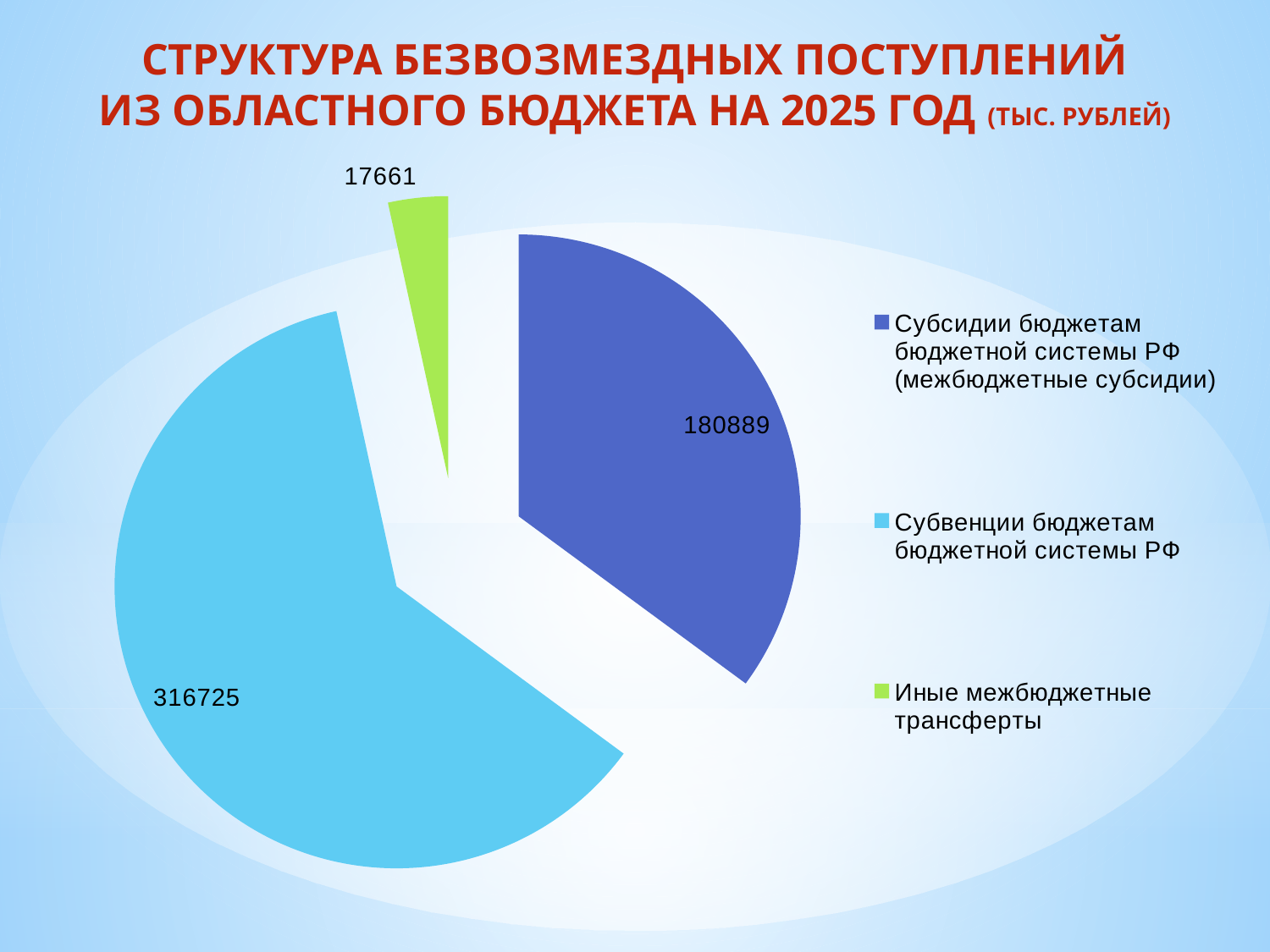
Which is larger: the value for "Субсидии бюджетам бюджетной системы РФ (межбюджетные субсидии)" or the value for "Иные межбюджетные трансферты"? Субсидии бюджетам бюджетной системы РФ (межбюджетные субсидии) What is the difference between the values for "Субвенции бюджетам бюджетной системы РФ" and "Субсидии бюджетам бюджетной системы РФ (межбюджетные субсидии)"? 135836 What is the total of all slices in the pie chart? 515275 What is the value for "Субсидии бюджетам бюджетной системы РФ (межбюджетные субсидии)"? 180889 What is the difference between the values for "Субсидии бюджетам бюджетной системы РФ (межбюджетные субсидии)" and "Иные межбюджетные трансферты"? 163228 What is the value for "Субвенции бюджетам бюджетной системы РФ"? 316725 Which category has the smallest slice of the pie? Иные межбюджетные трансферты How many categories does the pie chart have? 3 What type of chart is shown on the slide? Pie chart What colour is the slice for "Иные межбюджетные трансферты"? Green Which category has the largest slice of the pie? Субвенции бюджетам бюджетной системы РФ What is the value for "Иные межбюджетные трансферты"? 17661